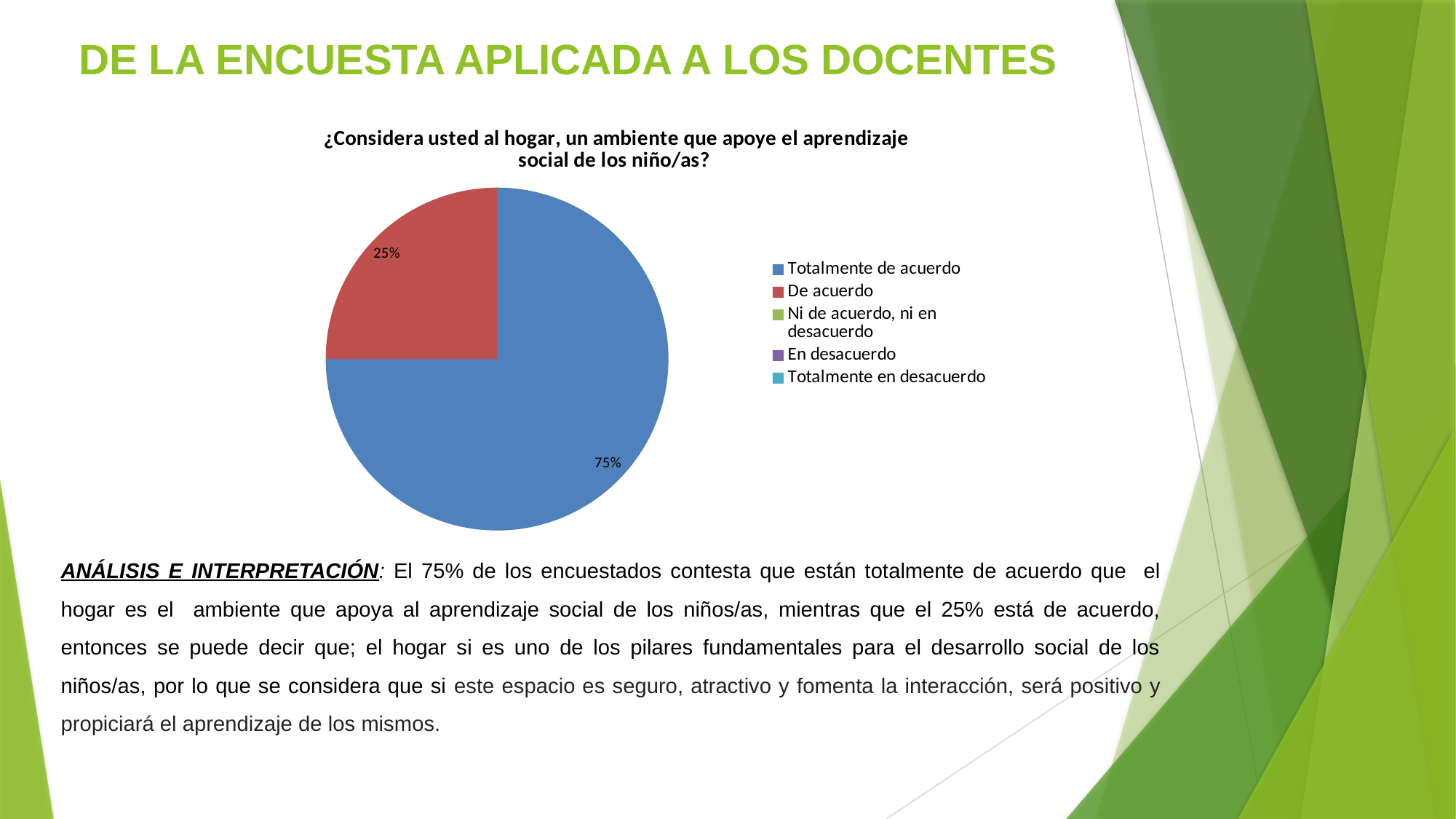
How many slices are visible in the pie? 2 What kind of chart is shown on the slide? Pie chart Which category has the largest slice of the pie? Totalmente de acuerdo What is the difference in percentage points between the "Totalmente de acuerdo" slice and the "De acuerdo" slice? 50% What share of the pie does "Totalmente de acuerdo" represent? 75% What share of the pie does "De acuerdo" represent? 25% What colour is the "De acuerdo" slice? Red What is the title of the chart? ¿Considera usted al hogar, un ambiente que apoye el aprendizaje social de los niño/as? How many entries does the legend list? 5 Which of the two visible slices is larger, "Totalmente de acuerdo" or "De acuerdo"? Totalmente de acuerdo